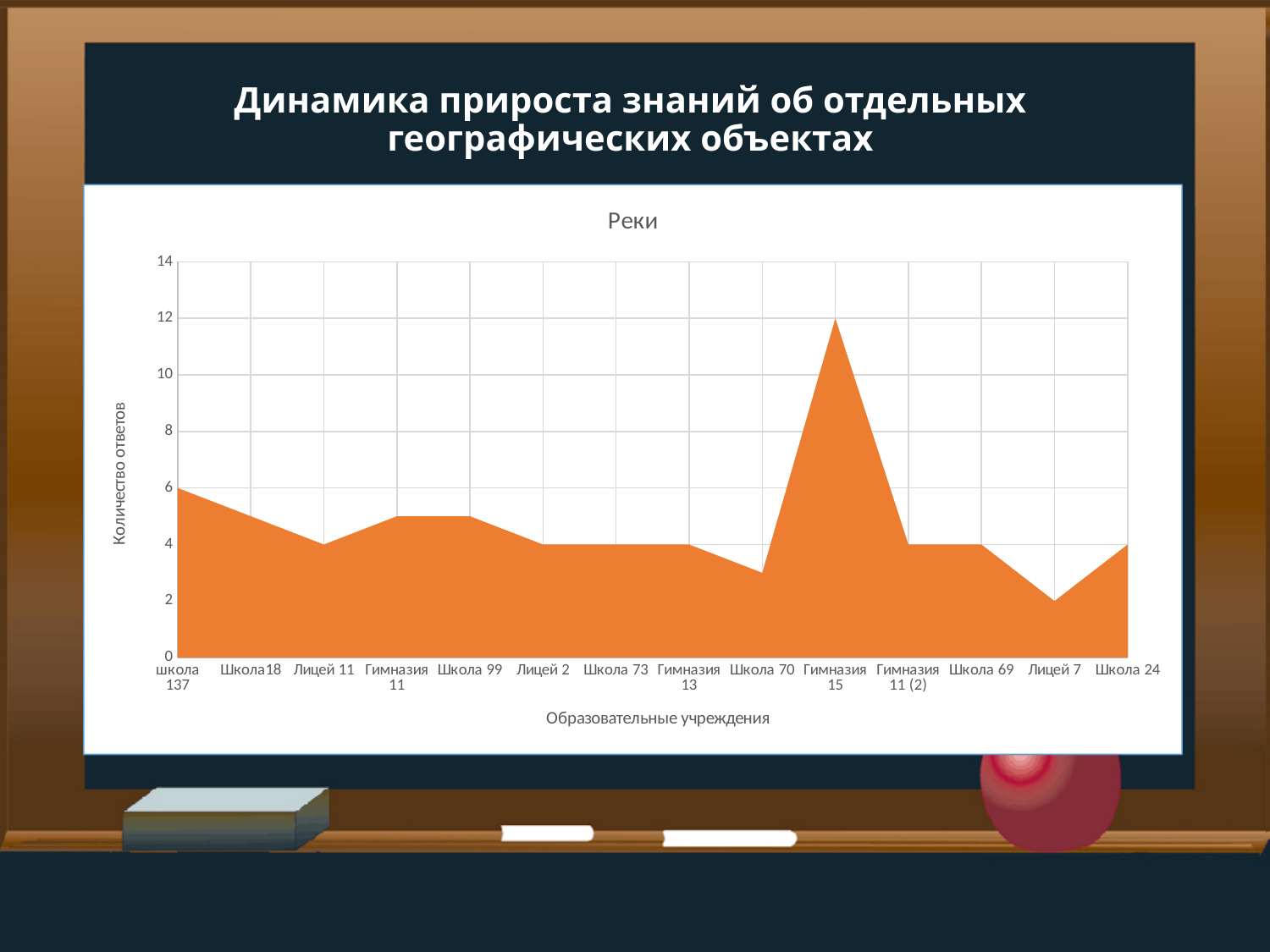
What is the value for школа 137? 6 Is the value for Школа 99 greater or less than 4? greater Is the value for Школа 70 greater or less than 4? less Which has a larger value, Гимназия 15 or Школа 24? Гимназия 15 Which educational institution has the lowest value? Лицей 7 What is the value for Лицей 7? 2 What kind of chart is shown on the slide? area chart What is the title of the chart? Реки Which educational institution has the highest value? Гимназия 15 How many educational institutions are plotted along the x axis? 14 What is the label of the vertical axis? Количество ответов What is the value for Гимназия 15? 12